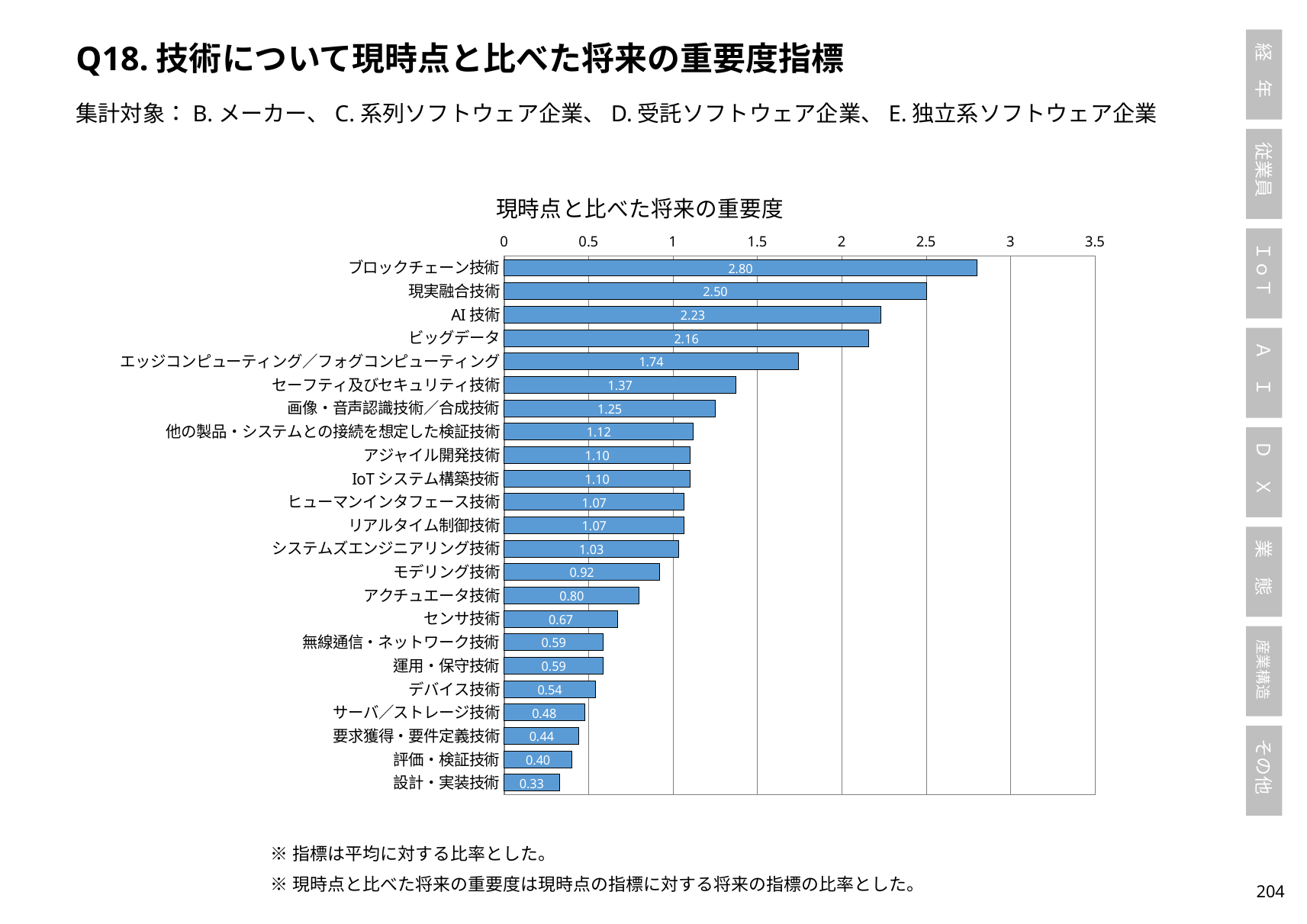
What is the value for ブロックチェーン技術? 2.80 Which category has the lowest value? 設計・実装技術 What is the difference between the values for ブロックチェーン技術 and 現実融合技術? 0.30 How many categories are shown in the chart? 23 Is the value for モデリング技術 greater or less than 1? less What kind of chart is shown on the slide? bar chart What is the value for セーフティ及びセキュリティ技術? 1.37 What is the title of the chart? 現時点と比べた将来の重要度 What is the value for 設計・実装技術? 0.33 What is the value for AI 技術? 2.23 Which is larger, the value for ビッグデータ or the value for エッジコンピューティング／フォグコンピューティング? ビッグデータ Which category has the highest value? ブロックチェーン技術